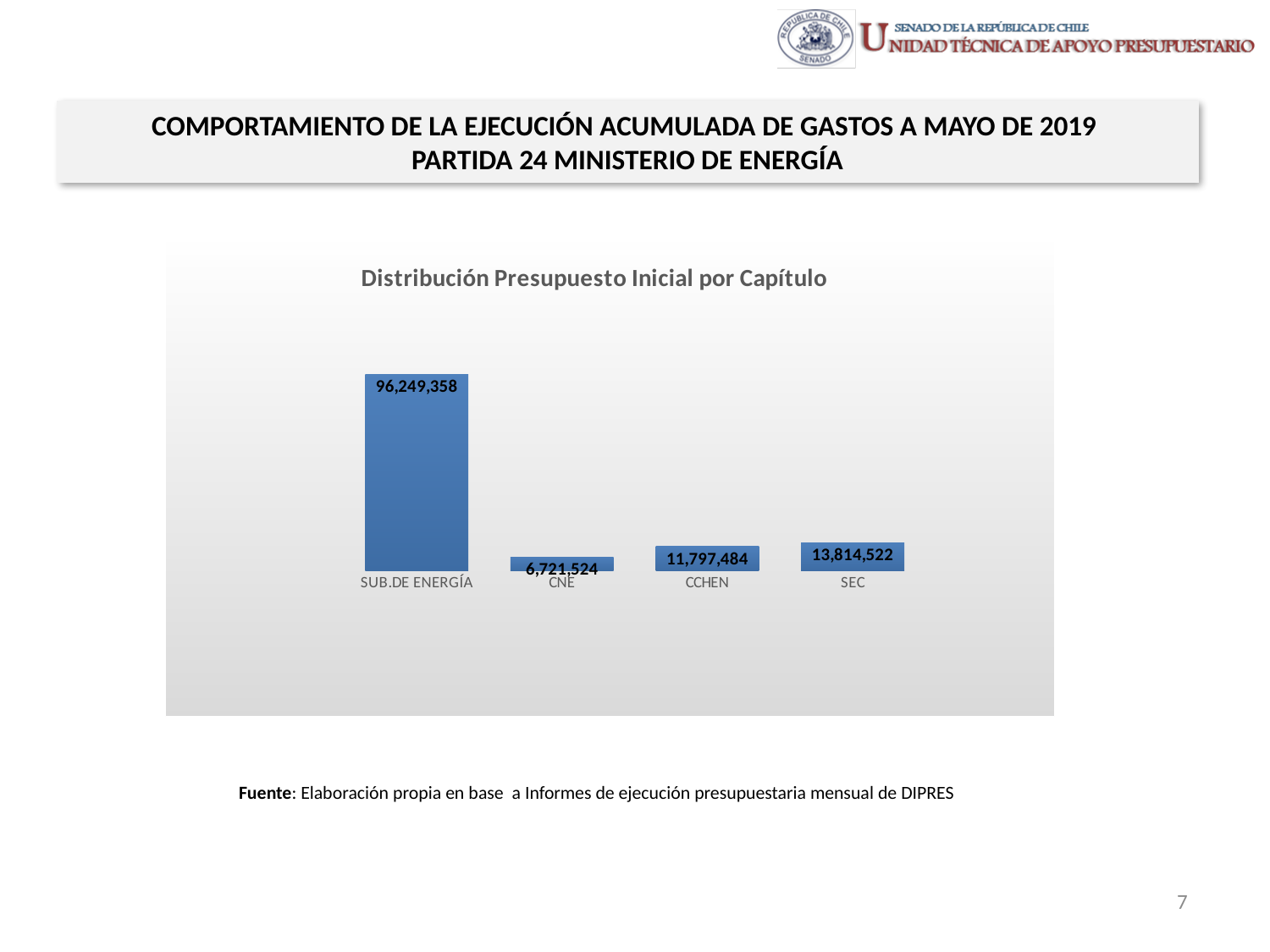
What is the value for CCHEN? 11,797,484 What kind of chart is shown on the slide? Bar chart How many categories are shown in the chart? 4 What is the value for SUB.DE ENERGÍA? 96,249,358 Which is larger, the value for CCHEN or the value for SEC? SEC What is the value for SEC? 13,814,522 What is the value for CNE? 6,721,524 Which category has the highest value? SUB.DE ENERGÍA What is the difference between the values for SEC and CCHEN? 2,017,038 What is the difference between the values for SUB.DE ENERGÍA and CNE? 89,527,834 Which category has the lowest value? CNE What is the title of the chart? Distribución Presupuesto Inicial por Capítulo